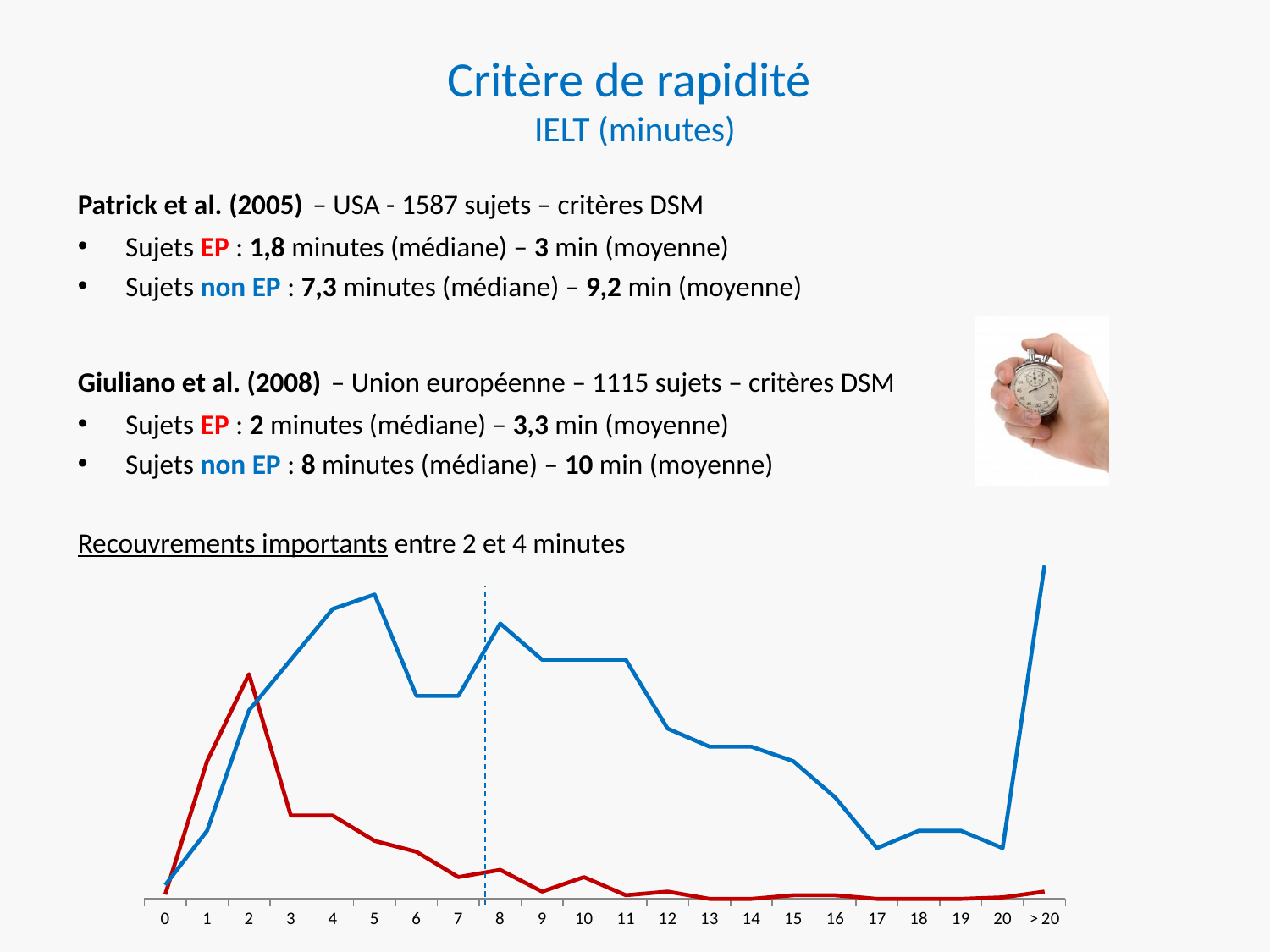
At which x-axis category does the blue line reach its highest point? > 20 What is the last category label on the x axis of the chart? > 20 How many categories are shown on the x axis of the chart? 22 Does the blue line rise or fall between x = 0 and x = 4? rise At which x-axis category does the red line reach its highest point? 2 Does the red line rise or fall between x = 2 and x = 7? fall At x = 1, which line is higher, the red line or the blue line? red line What kind of chart is shown at the bottom of the slide? line chart How many lines are plotted on the chart? 2 At x = 2, which line is higher, the red line or the blue line? red line At which x-axis category is the blue line at its lowest point? 0 At x = 5, which line is higher, the red line or the blue line? blue line